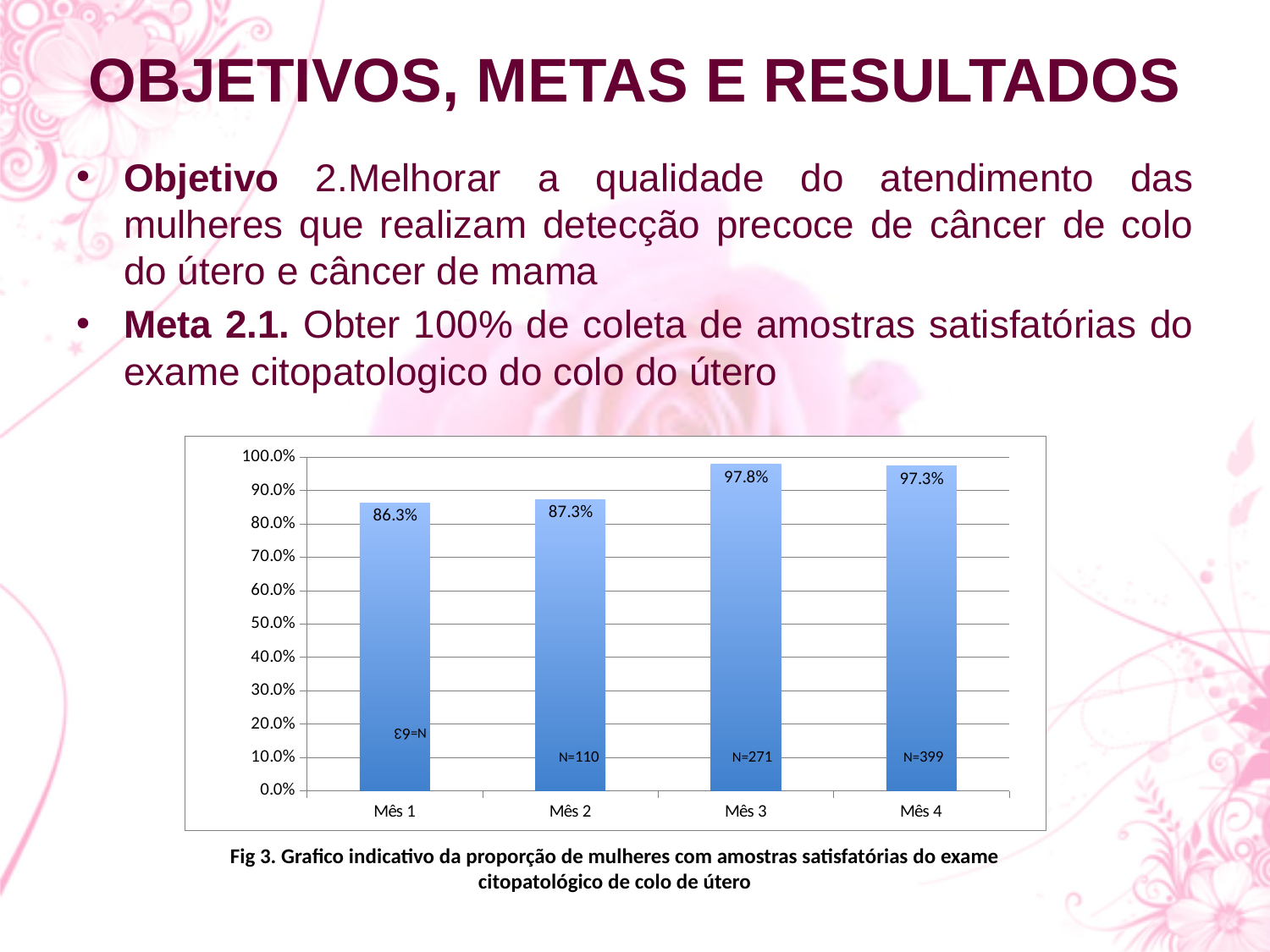
Which month has the highest value? Mês 3 What kind of chart is shown on the slide? Bar chart Which month has the lowest value? Mês 1 What is the difference between the values for Mês 3 and Mês 1? 11.5% What is the value for Mês 4? 97.3% What is the N value printed inside the bar for Mês 4? N=399 What is the value for Mês 3? 97.8% How many months (categories) are shown on the x axis? 4 Which is larger, the value for Mês 2 or the value for Mês 4? Mês 4 What is the value for Mês 1? 86.3% What is the figure number given in the caption below the chart? Fig 3 What is the difference between the values for Mês 2 and Mês 1? 1.0%